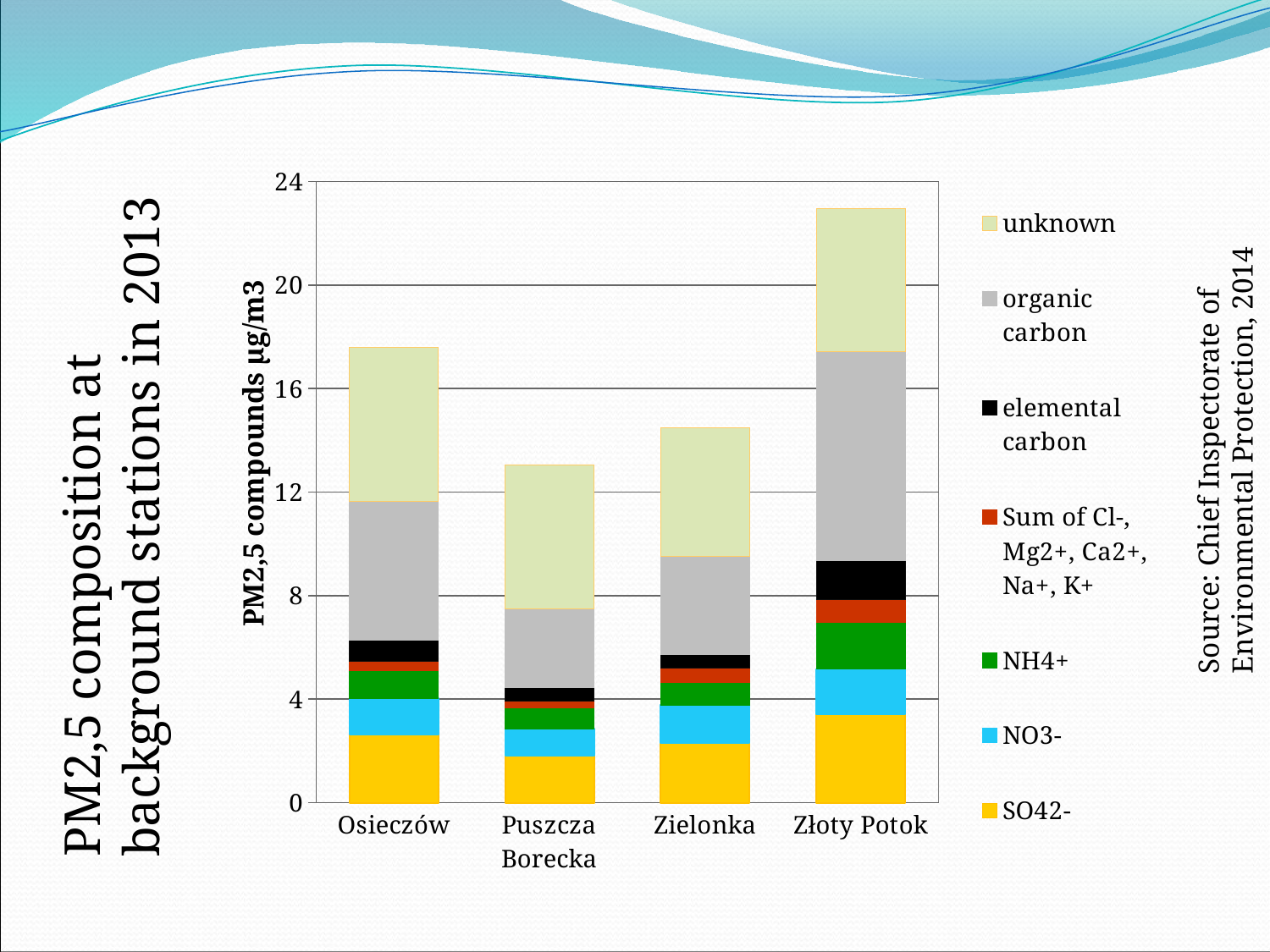
Which station has a larger total stacked bar, Osieczów or Zielonka? Osieczów How many series does the legend list? 7 Is the total stacked bar for Złoty Potok greater or less than 20? greater Which station has the tallest stacked bar (highest total PM2,5 compounds)? Złoty Potok Is the total stacked bar for Zielonka greater or less than 16? less What kind of chart is shown on the slide? stacked bar chart Which station has the shortest stacked bar (lowest total PM2,5 compounds)? Puszcza Borecka Is the total stacked bar for Osieczów greater or less than 16? greater How many stations (categories) are shown on the x axis? 4 What is the label of the y axis? PM2,5 compounds µg/m3 Which series is shown at the bottom of each stacked bar? SO42-